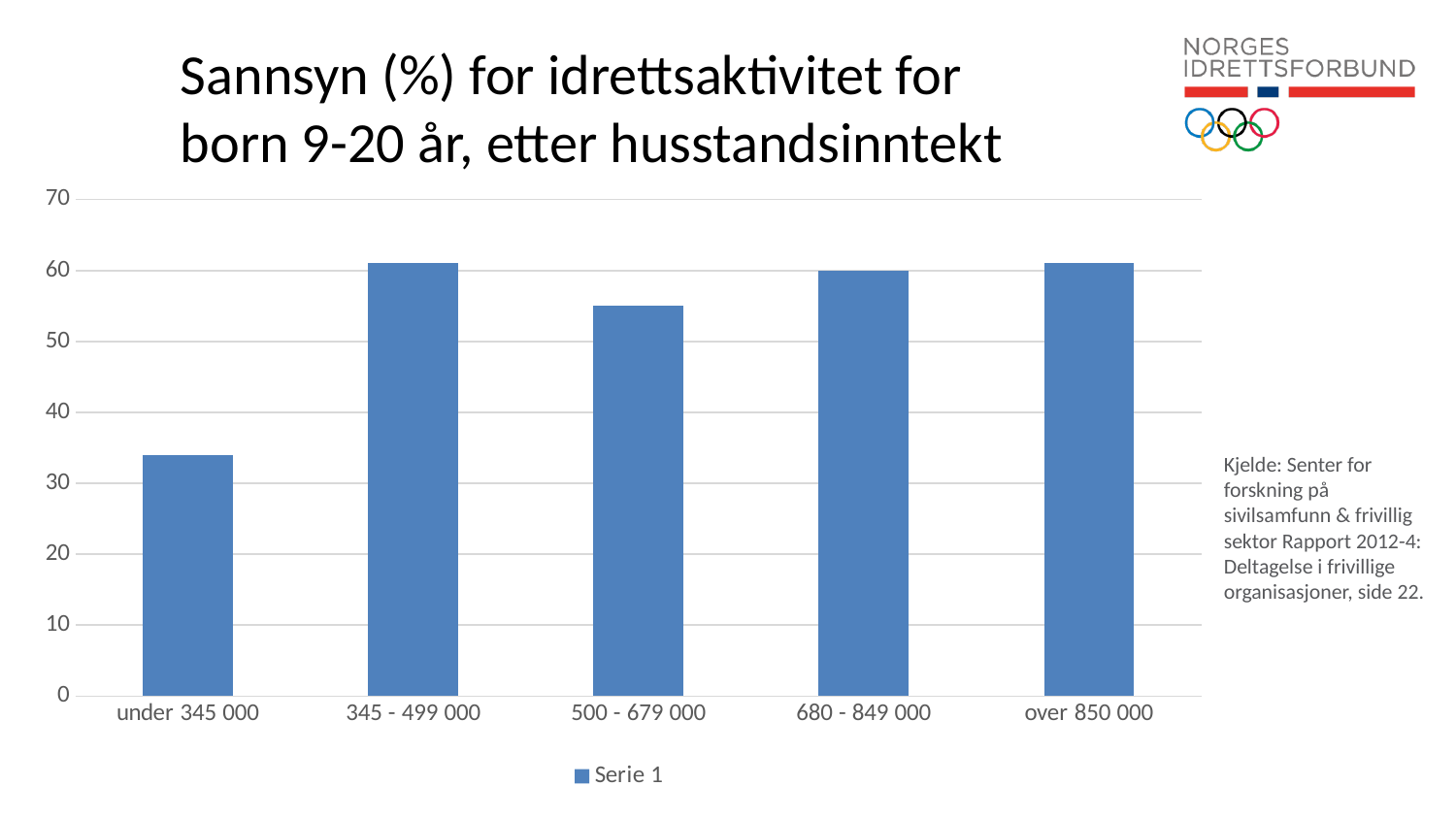
Which is larger, the value for '345 - 499 000' or the value for '500 - 679 000'? 345 - 499 000 Which income category has the lowest value? under 345 000 Is the value for 'under 345 000' greater or less than 30? greater Which is larger, the value for 'under 345 000' or the value for '500 - 679 000'? 500 - 679 000 How many income categories are shown on the x axis? 5 Is the value for '500 - 679 000' greater or less than 60? less Is the value for 'over 850 000' greater or less than 50? greater How many series does the legend list? 1 What kind of chart is shown on the slide? bar chart What is the name of the series shown in the legend? Serie 1